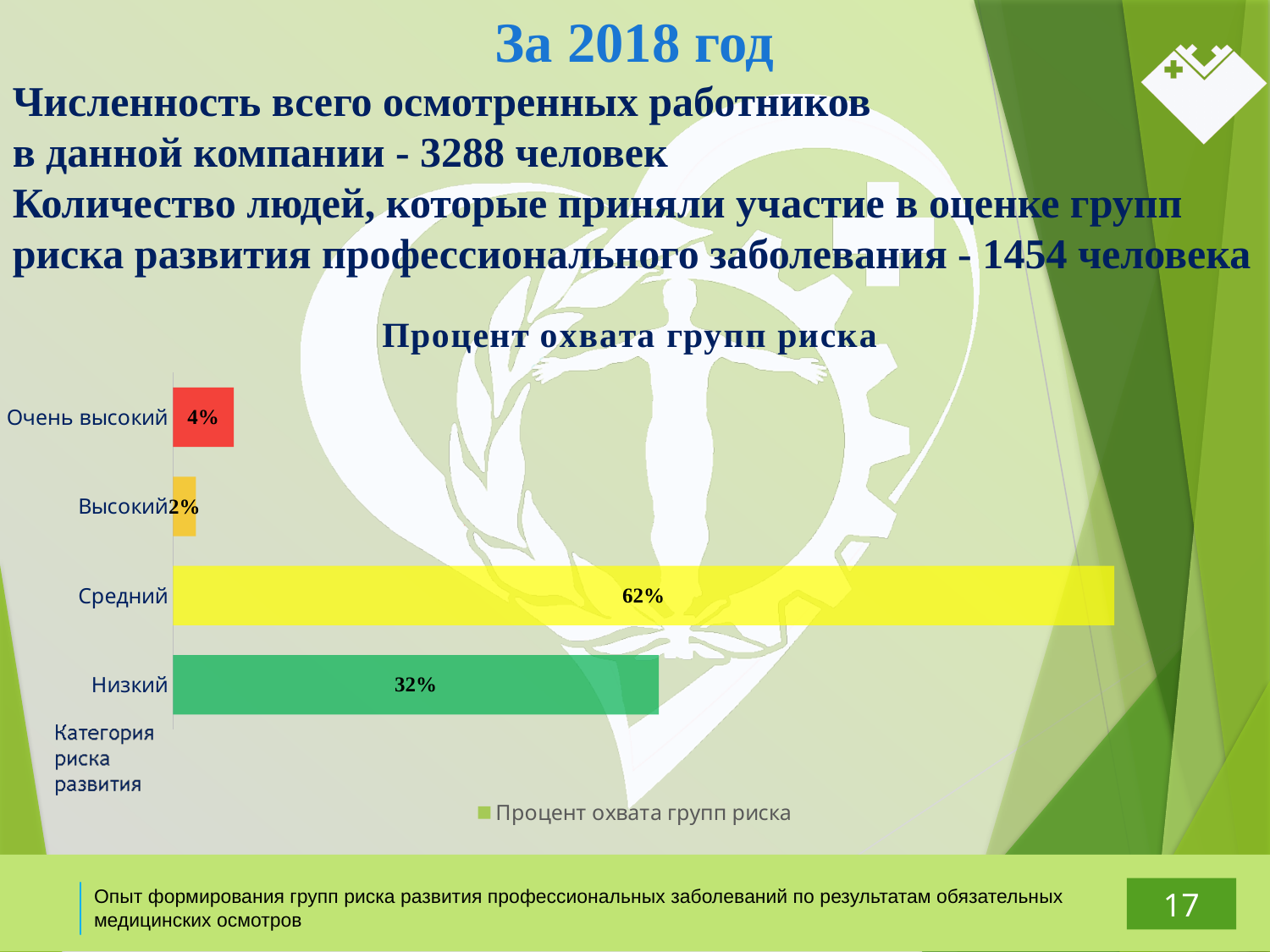
How many series does the legend list? 1 How many categories are shown in the chart? 4 What kind of chart is shown on the slide? Bar chart What is the value for the 'Очень высокий' category? 4% Which category has the highest value? Средний What is the title of the chart? Процент охвата групп риска What is the difference between the values for 'Средний' and 'Низкий'? 30% What is the value for the 'Средний' category in the 'Процент охвата групп риска' chart? 62% What is the value for the 'Низкий' category? 32% Which is larger, the value for 'Очень высокий' or the value for 'Высокий'? Очень высокий Which category has the lowest value? Высокий What is the value for the 'Высокий' category? 2%